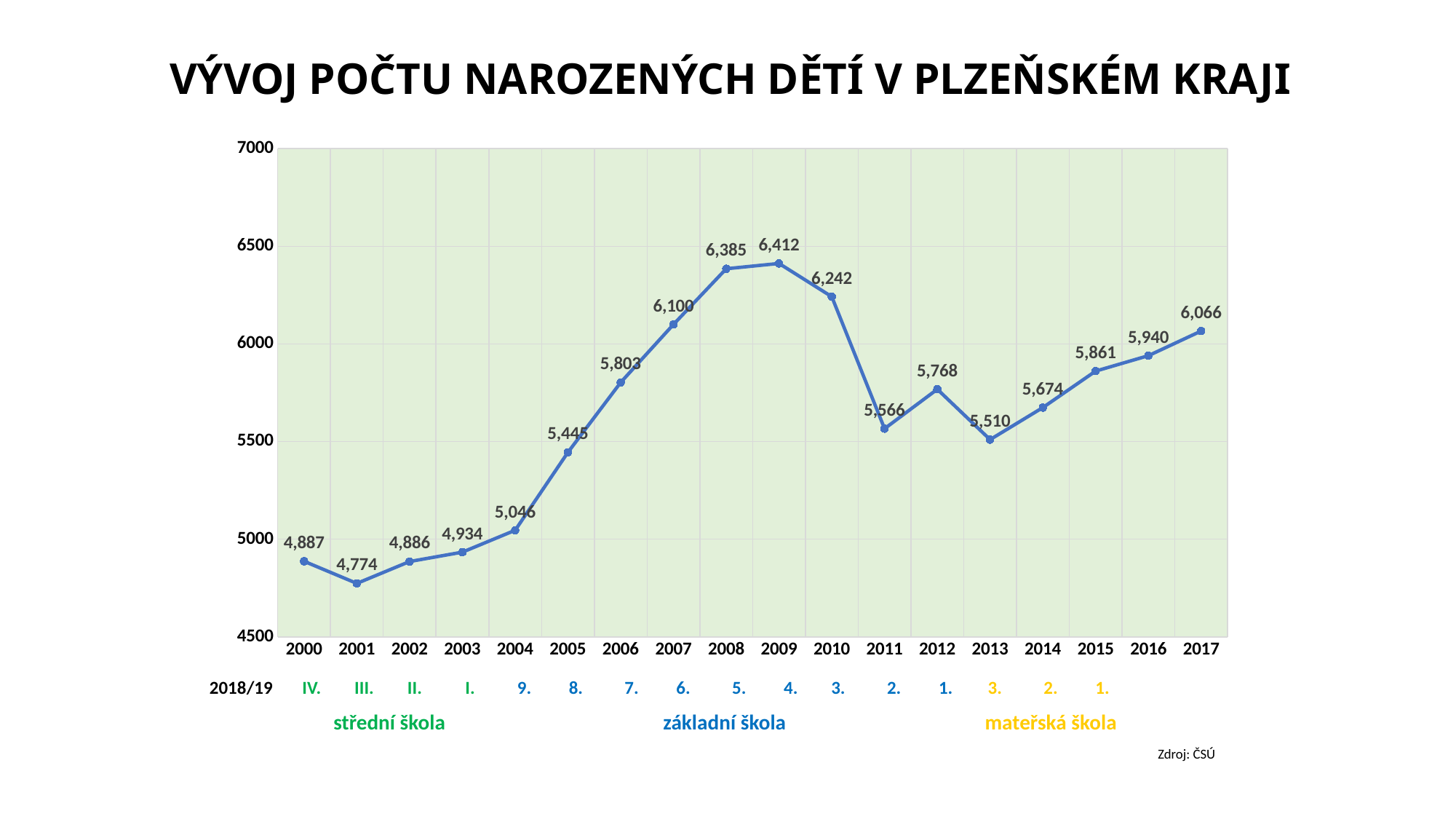
Which year has the highest value? 2009 Is the value for 2008 greater or less than 6000? greater Which is larger, the value for 2012 or the value for 2013? 2012 Which year has the lowest value? 2001 What is the value for 2009? 6,412 How many years are plotted on the x axis? 18 What is the value for 2001? 4,774 What is the value for 2017? 6,066 What is the difference between the values for 2009 and 2011? 846 Do the values rise or fall from 2013 to 2017? rise What kind of chart is shown? line chart What is the title of the chart? VÝVOJ POČTU NAROZENÝCH DĚTÍ V PLZEŇSKÉM KRAJI